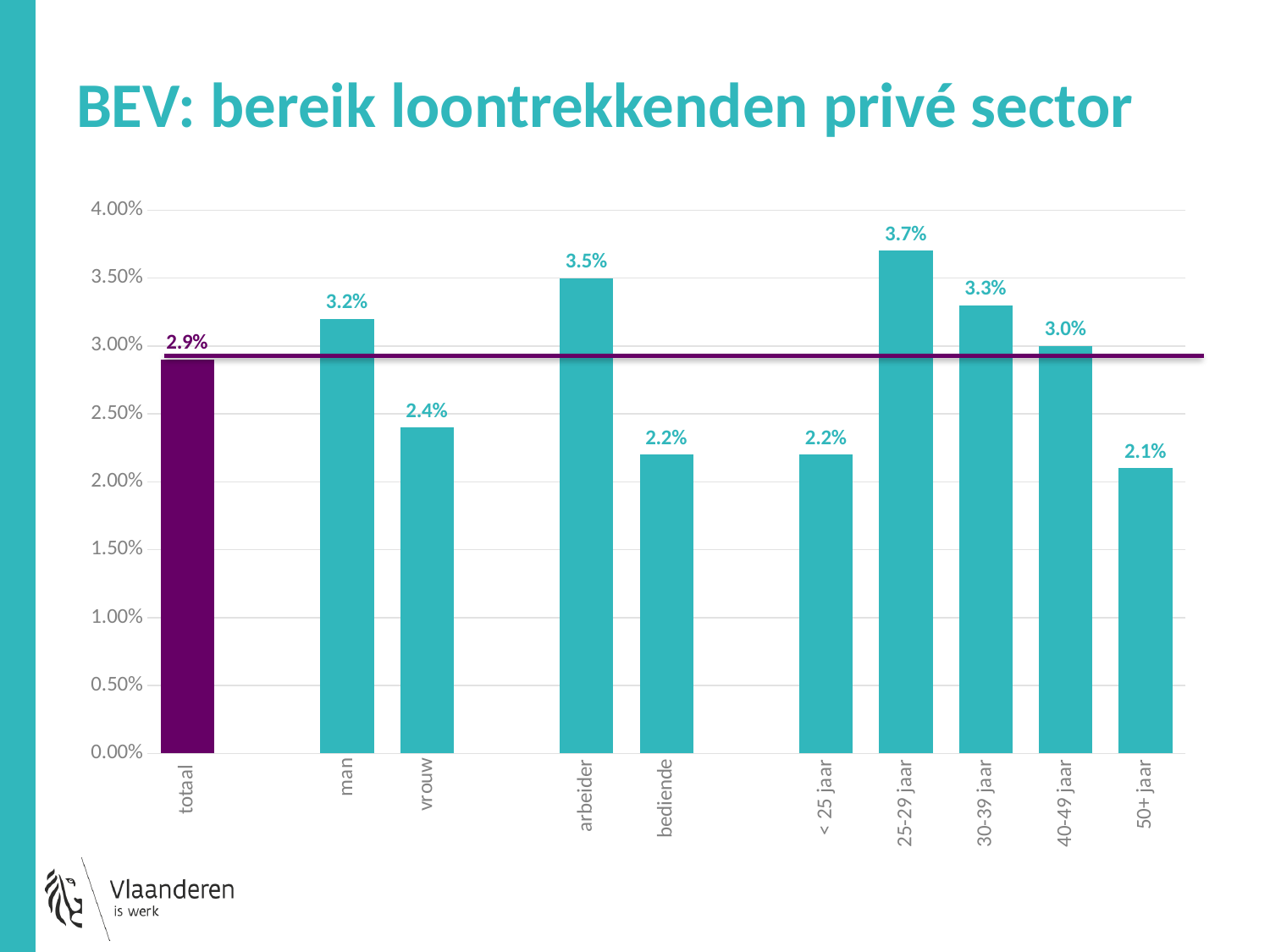
What is the value for 'bediende'? 2.2% How many categories are shown on the x axis? 10 Which category has the lowest value? 50+ jaar What kind of chart is shown on the slide? bar chart What is the difference between the values for 'man' and 'vrouw'? 0.8% Which is larger, the value for '30-39 jaar' or the value for '40-49 jaar'? 30-39 jaar What is the difference between the values for 'arbeider' and 'bediende'? 1.3% Which category has the highest value? 25-29 jaar What is the value for '40-49 jaar'? 3.0% What is the value for 'totaal'? 2.9% What is the title of the slide? BEV: bereik loontrekkenden privé sector What is the value for 'man'? 3.2%